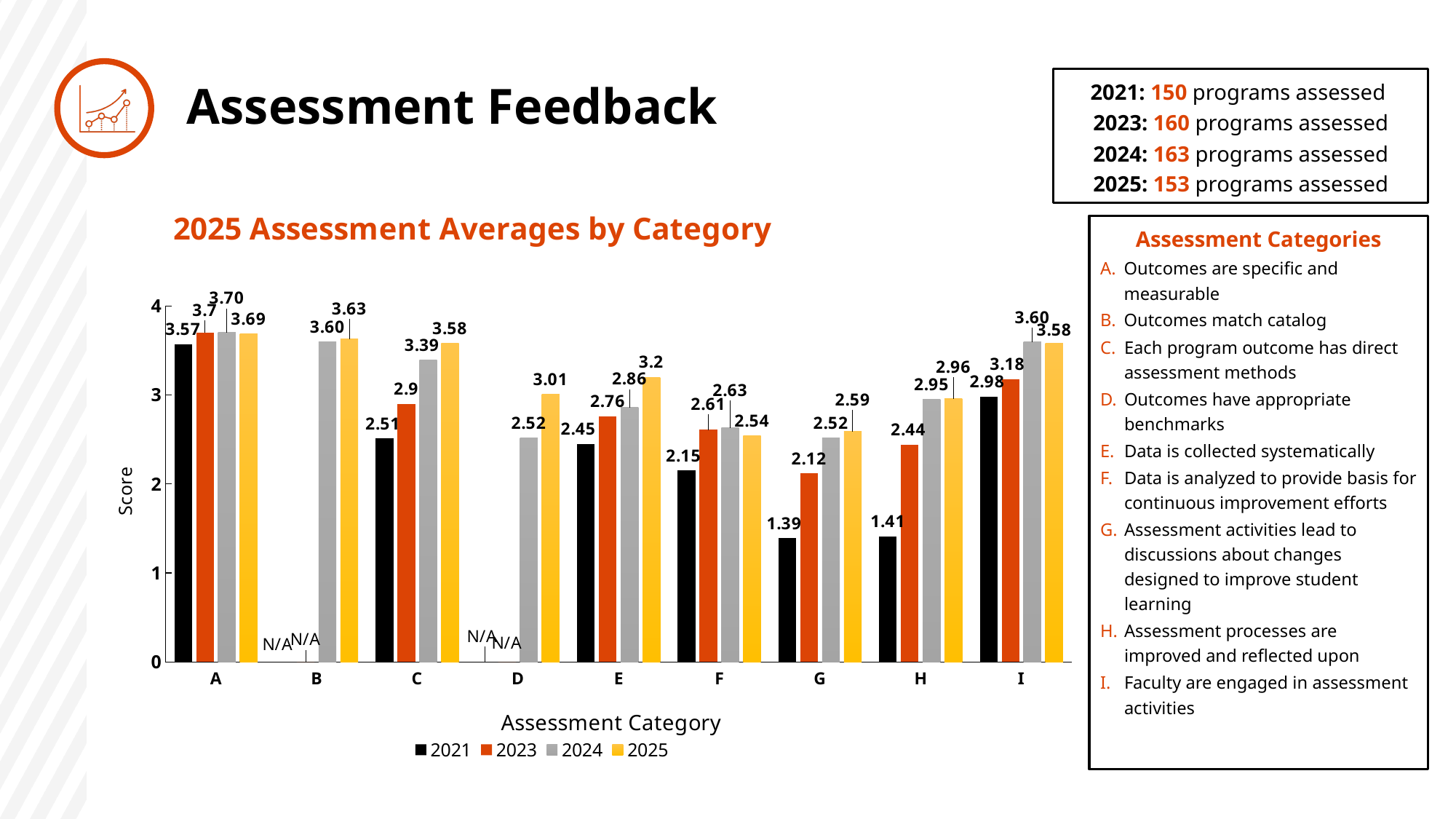
What kind of chart is shown? Bar chart Do the scores for category E rise or fall from 2021 to 2025? Rise Which categories show N/A for the 2021 and 2023 series? B and D Which category has the highest 2025 score? A What is the 2021 score for category G? 1.39 How many series does the legend list? 4 Which category has the lowest 2021 score? G How many assessment categories are shown on the x axis? 9 What is the 2024 score for category D? 2.52 Which is larger, the 2024 score for category F or the 2025 score for category F? 2024 (2.63) What is the difference between the 2025 and 2021 scores for category H? 1.55 What is the 2025 score for category C? 3.58